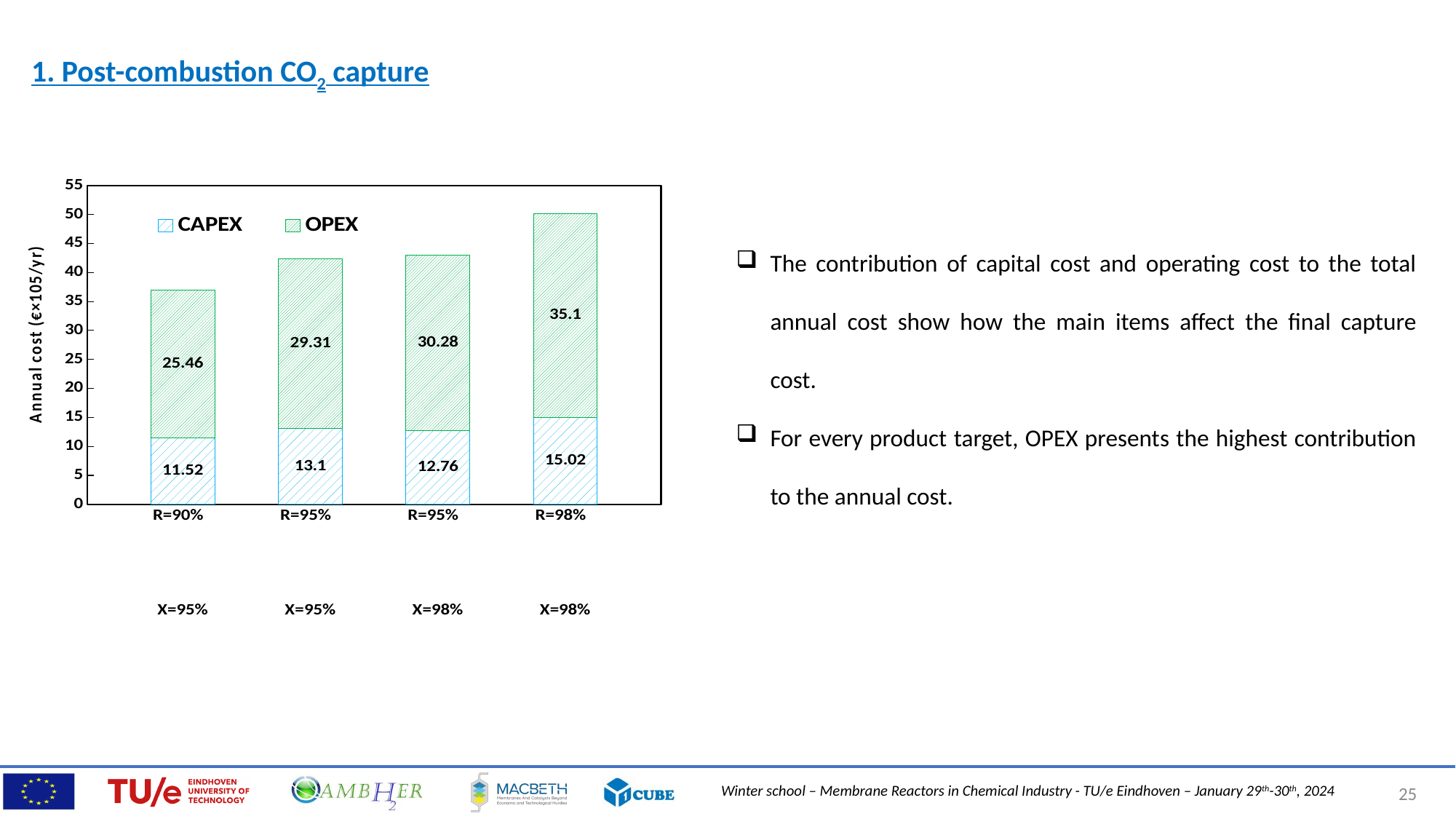
What is the total annual cost (CAPEX plus OPEX) for the bar labelled R=98%, X=98%? 50.12 Which bar has the highest OPEX value? R=98%, X=98% Which bar has the lowest CAPEX value? R=90%, X=95% What is the OPEX value for the bar labelled R=95%, X=98%? 30.28 How many bars are plotted in the chart? 4 What is the CAPEX value for the bar labelled R=95%, X=95%? 13.1 How many series does the chart legend list? 2 What is the CAPEX value for the bar labelled R=90%, X=95%? 11.52 What kind of chart is shown on the slide? stacked bar chart What is the difference between the OPEX values for R=98%, X=98% and R=90%, X=95%? 9.64 Which is larger, the CAPEX value for R=95%, X=95% or the CAPEX value for R=95%, X=98%? R=95%, X=95% What is the OPEX value for the bar labelled R=98%, X=98%? 35.1